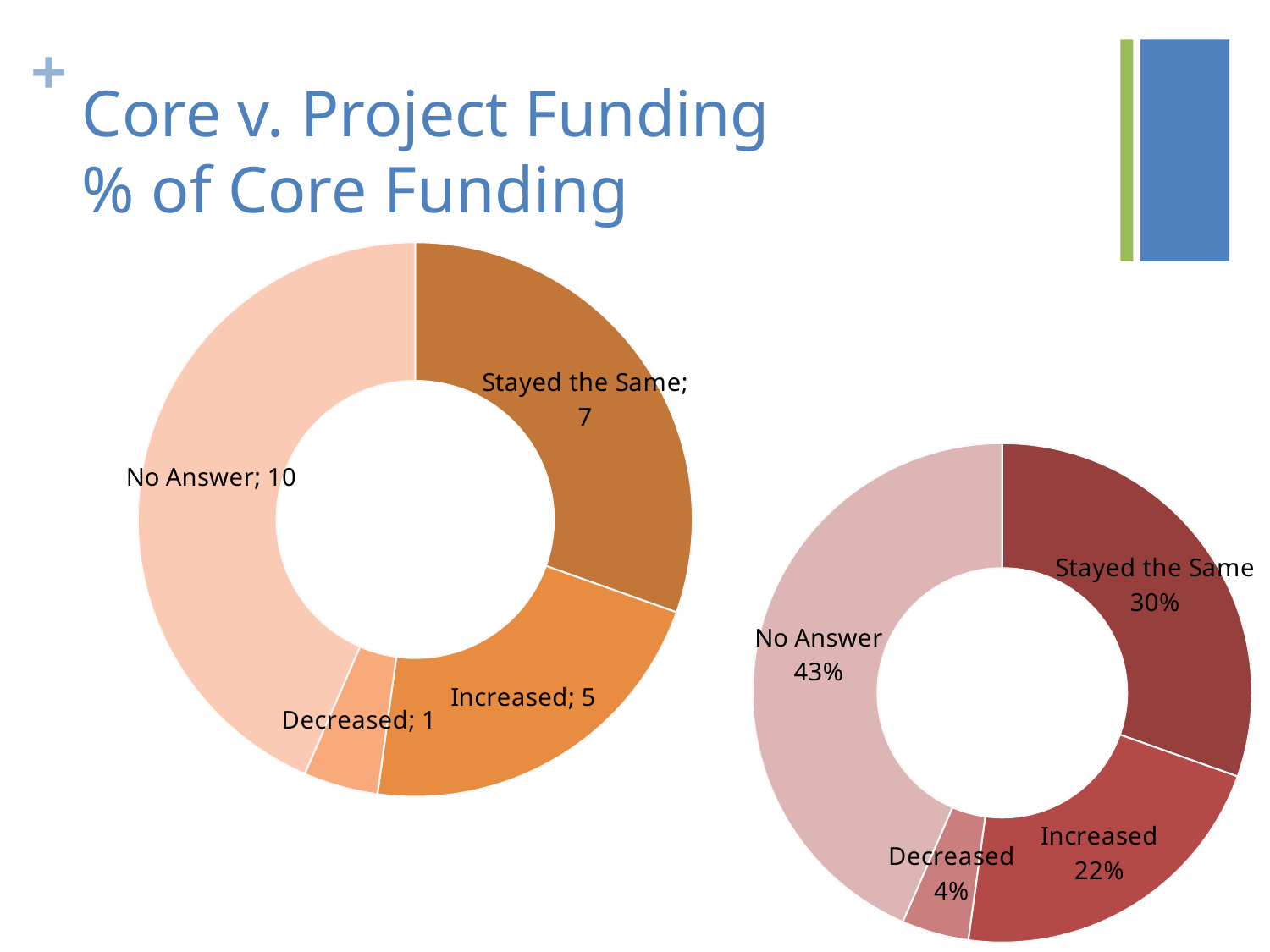
On the left (orange) doughnut chart, what is the total of all four values? 23 On the right (red) doughnut chart, what percentage is shown for No Answer? 43% On the right (red) doughnut chart, which category has the smallest share? Decreased What kind of chart is the right (red) chart? Doughnut chart On the right (red) doughnut chart, what percentage is shown for Increased? 22% How many categories does the left (orange) doughnut chart show? 4 On the left (orange) doughnut chart, what is the value for No Answer? 10 On the left (orange) doughnut chart, which category has the largest value? No Answer On the left (orange) doughnut chart, what is the difference between the values for Stayed the Same and Increased? 2 On the left (orange) doughnut chart, which category has the smallest value? Decreased On the left (orange) doughnut chart, what is the value for Stayed the Same? 7 On the right (red) doughnut chart, which is larger, the share for Stayed the Same or the share for Increased? Stayed the Same